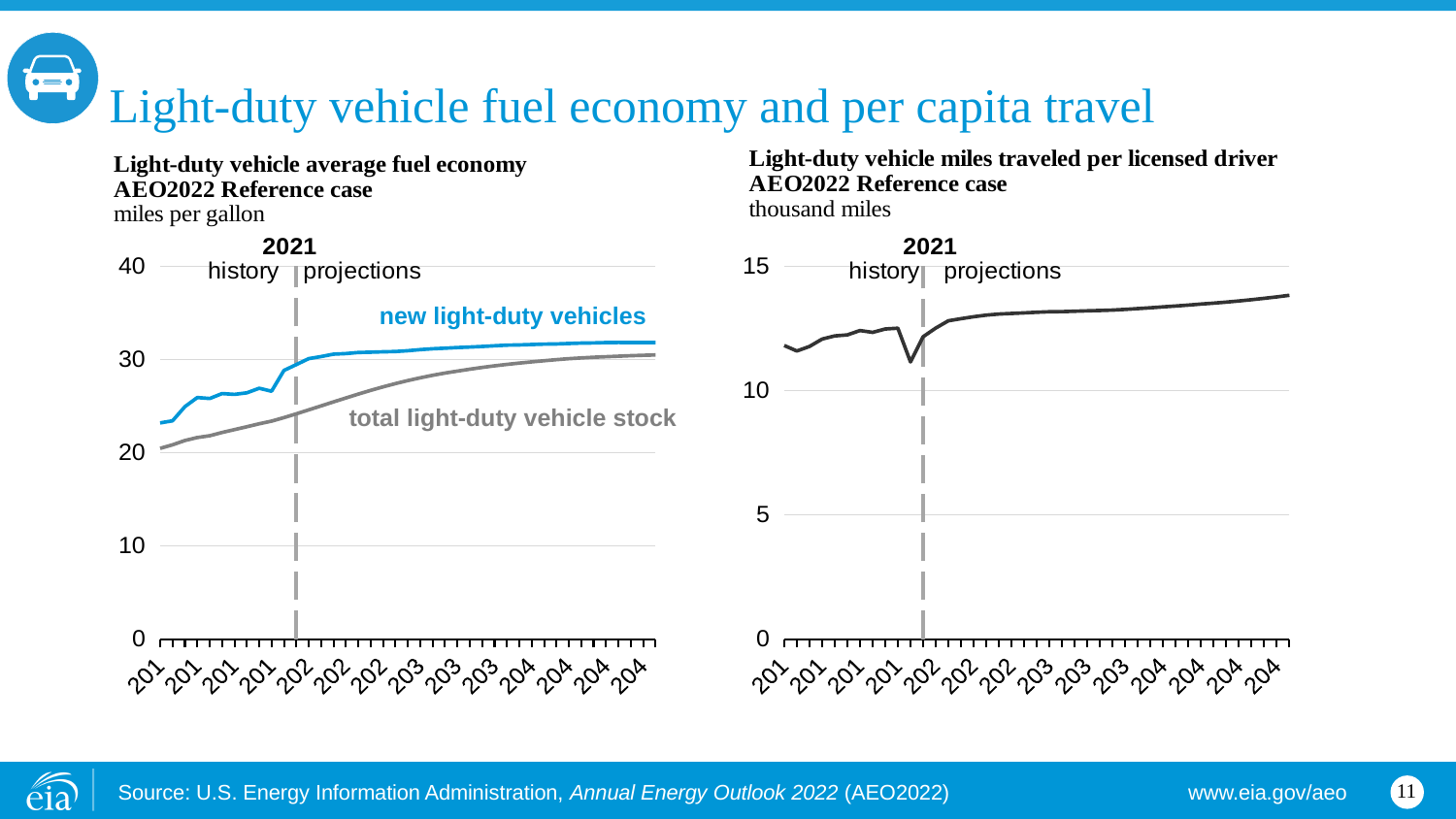
In the right chart, 'Light-duty vehicle miles traveled per licensed driver', do the values generally rise or fall over the projection period? rise In the left chart, 'Light-duty vehicle average fuel economy', do the values for total light-duty vehicle stock rise or fall over the projection period? rise In the left chart, 'Light-duty vehicle average fuel economy', is the value for new light-duty vehicles in 2021 greater or less than 20? greater What kind of chart is the left chart, 'Light-duty vehicle average fuel economy'? line chart In the left chart, 'Light-duty vehicle average fuel economy', how many series are plotted? 2 What unit is used on the y axis of the left chart, 'Light-duty vehicle average fuel economy'? miles per gallon What kind of chart is the right chart, 'Light-duty vehicle miles traveled per licensed driver'? line chart What year does the vertical dashed line separating history from projections mark in both charts? 2021 In the right chart, 'Light-duty vehicle miles traveled per licensed driver', is the value at the end of the projection period greater or less than 15? less In the right chart, 'Light-duty vehicle miles traveled per licensed driver', is the value in 2021 greater or less than 10? greater In the left chart, 'Light-duty vehicle average fuel economy', which series has the higher values: new light-duty vehicles or total light-duty vehicle stock? new light-duty vehicles